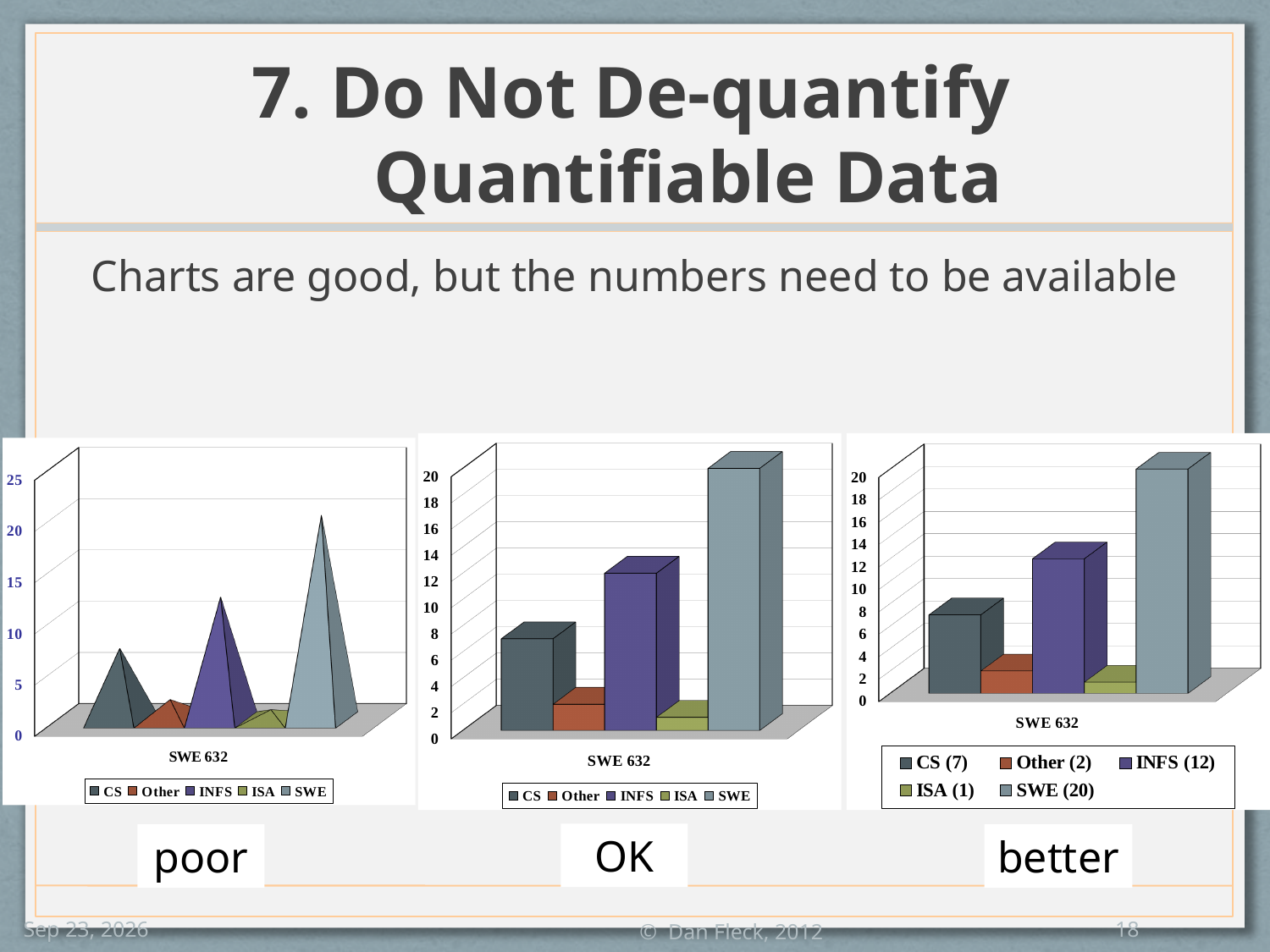
In the middle chart (labelled "OK"), is the value for Other greater or less than 5? less What kind of chart is the middle chart (labelled "OK")? bar chart What is the category label shown beneath the bars in the middle chart (labelled "OK")? SWE 632 In the right-hand chart (labelled "better"), what is the value for SWE? 20 In the right-hand chart (labelled "better"), what is the value for CS? 7 In the right-hand chart (labelled "better"), what is the value for INFS? 12 In the right-hand chart (labelled "better"), which is larger, the value for CS or the value for Other? CS In the right-hand chart (labelled "better"), which series has the lowest value? ISA In the right-hand chart (labelled "better"), which series has the highest value? SWE How many series does the legend of the right-hand chart (labelled "better") list? 5 In the right-hand chart (labelled "better"), what is the difference between the SWE value and the INFS value? 8 In the middle chart (labelled "OK"), is the value for SWE greater or less than 15? greater